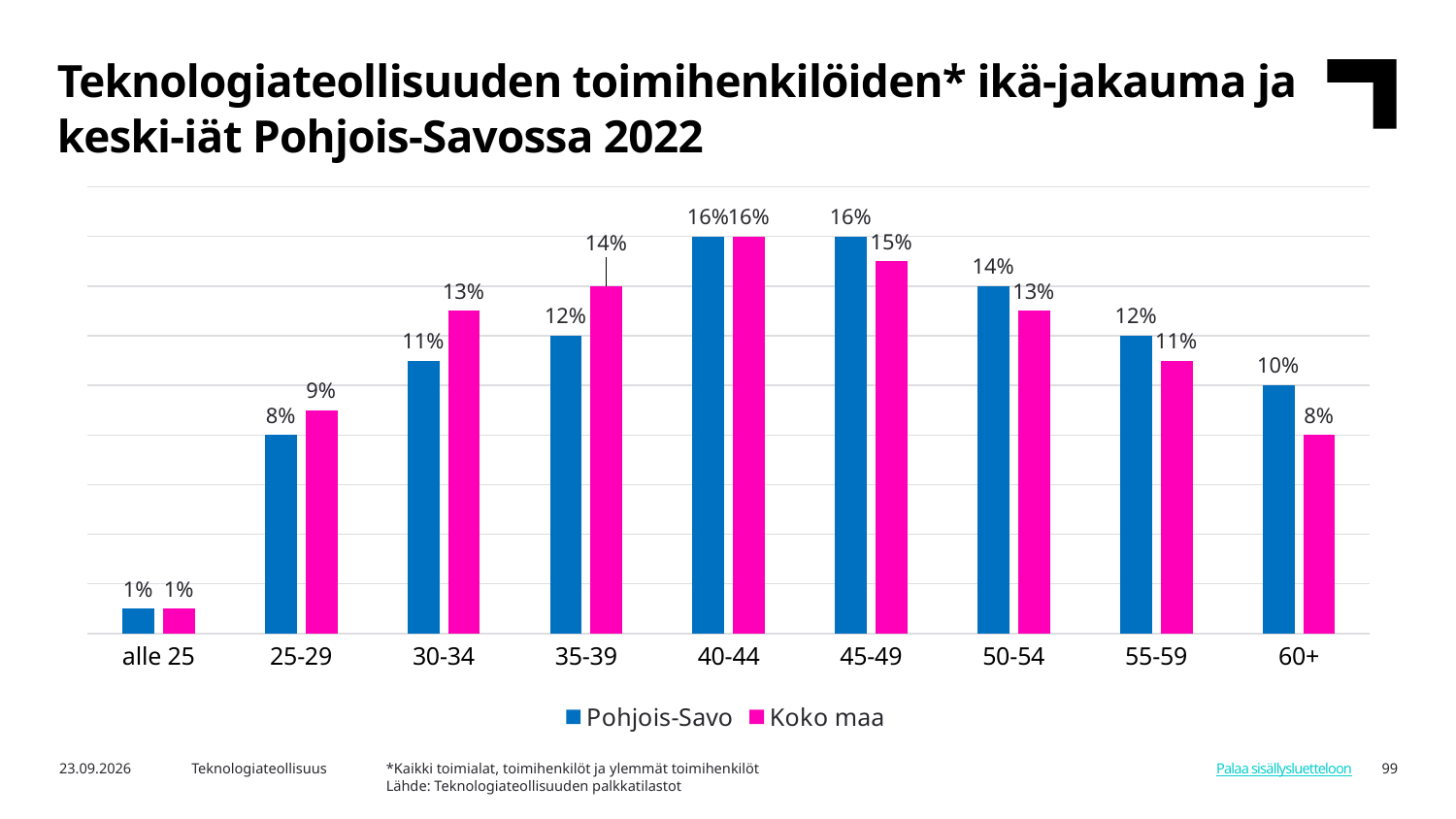
How many age groups are shown on the x axis? 9 Which age group has the highest value for Koko maa? 40-44 What is the value for Pohjois-Savo in the 30-34 age group? 11% How many series does the legend list? 2 Which age group has the lowest value for Pohjois-Savo? alle 25 What is the difference between the Pohjois-Savo and Koko maa values in the 60+ age group? 2% In the 30-34 age group, which series has the larger value, Pohjois-Savo or Koko maa? Koko maa What is the value for Pohjois-Savo in the 50-54 age group? 14% What kind of chart is shown on the slide? Bar chart What is the value for Koko maa in the 60+ age group? 8% Which series is shown in magenta in the legend? Koko maa What is the value for Koko maa in the 35-39 age group? 14%